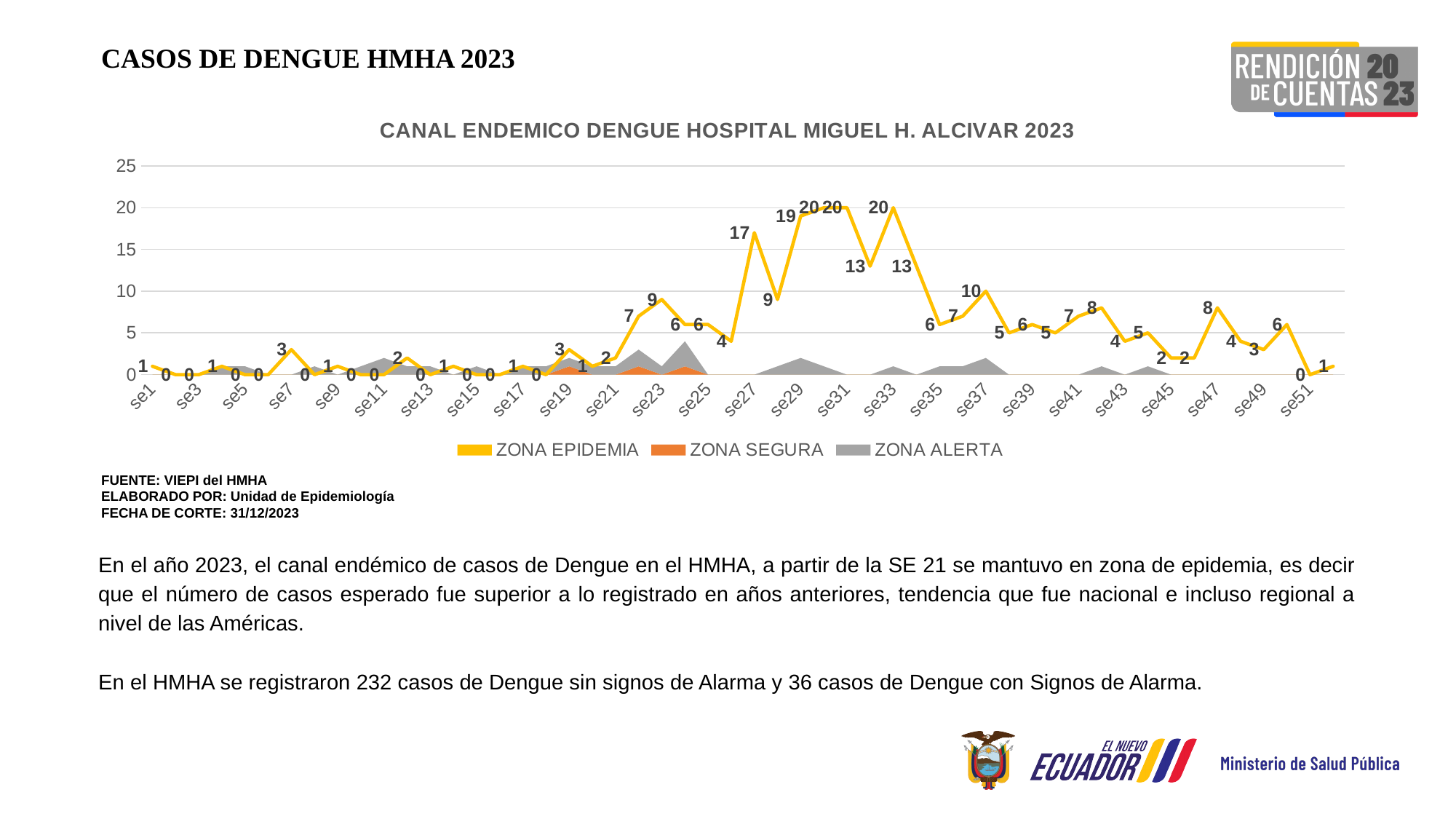
What is the value for se51 on the ZONA EPIDEMIA line? 0 Which has the larger value on the ZONA EPIDEMIA line, se27 or se47? se27 How many series does the legend list? 3 What is the value for se37 on the ZONA EPIDEMIA line? 10 What is the highest value labelled on the ZONA EPIDEMIA line? 20 What is the value for se7 on the ZONA EPIDEMIA line? 3 Do the values on the ZONA EPIDEMIA line rise or fall from se33 to se35? fall What kind of chart is shown? combination area and line chart What is the title of the chart? CANAL ENDEMICO DENGUE HOSPITAL MIGUEL H. ALCIVAR 2023 What is the difference between the values for se27 and se37 on the ZONA EPIDEMIA line? 7 Is the value for se29 on the ZONA EPIDEMIA line greater or less than 15? greater What is the value for se27 on the ZONA EPIDEMIA line? 17